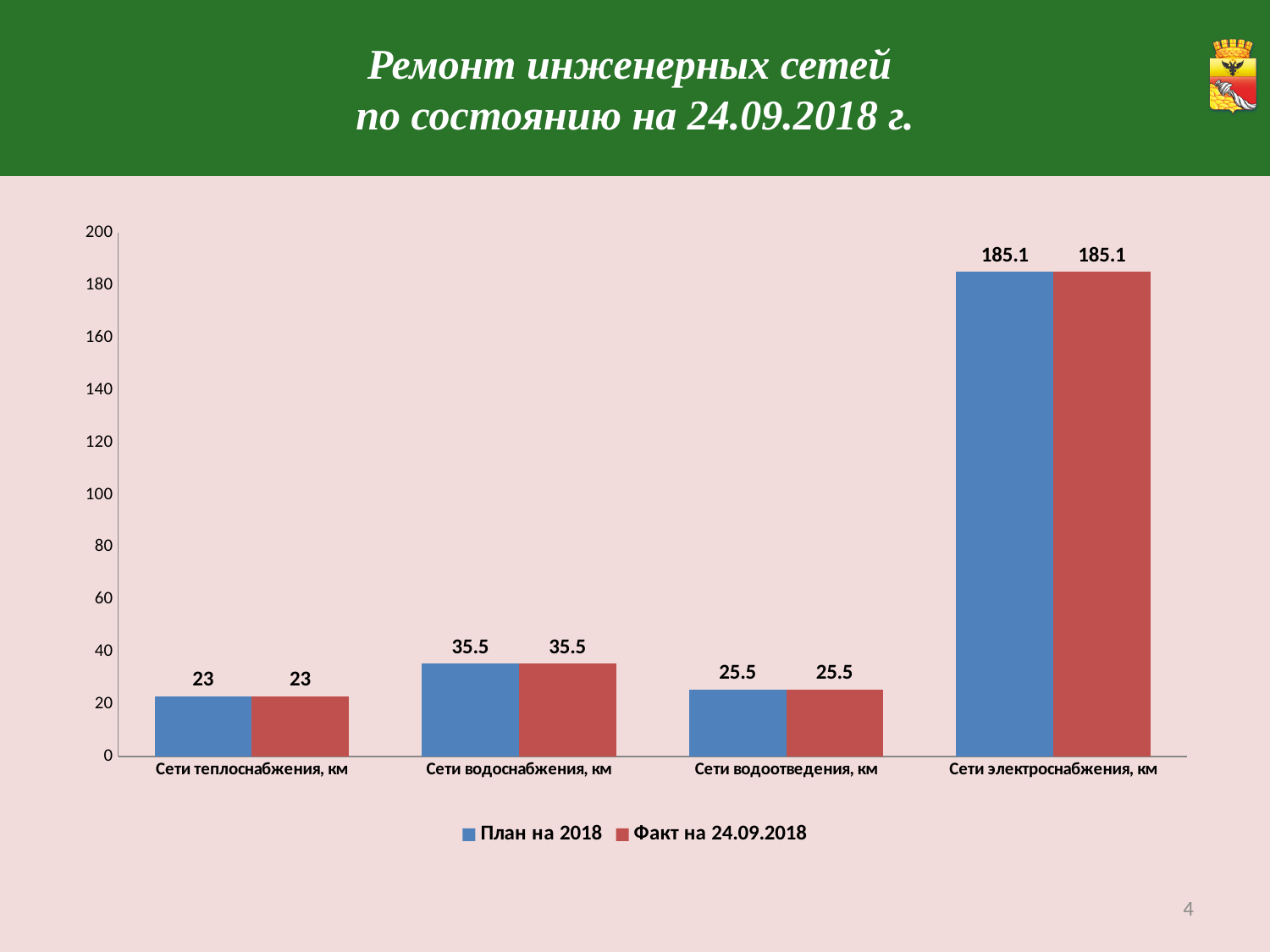
What is the value of 'Факт на 24.09.2018' for 'Сети водоотведения, км'? 25.5 Is the 'Факт на 24.09.2018' value for 'Сети электроснабжения, км' greater or less than 160? greater What is the difference between the 'План на 2018' values for 'Сети водоснабжения, км' and 'Сети водоотведения, км'? 10 Which category has the highest value for 'План на 2018'? Сети электроснабжения, км How many series does the legend list? 2 What is the value of 'План на 2018' for 'Сети теплоснабжения, км'? 23 How many categories are shown on the x axis? 4 What kind of chart is shown on the slide? bar chart What is the value of 'Факт на 24.09.2018' for 'Сети водоснабжения, км'? 35.5 Which is larger: the 'План на 2018' value for 'Сети водоснабжения, км' or for 'Сети теплоснабжения, км'? Сети водоснабжения, км Which category has the lowest value for 'Факт на 24.09.2018'? Сети теплоснабжения, км What is the value of 'План на 2018' for 'Сети электроснабжения, км'? 185.1